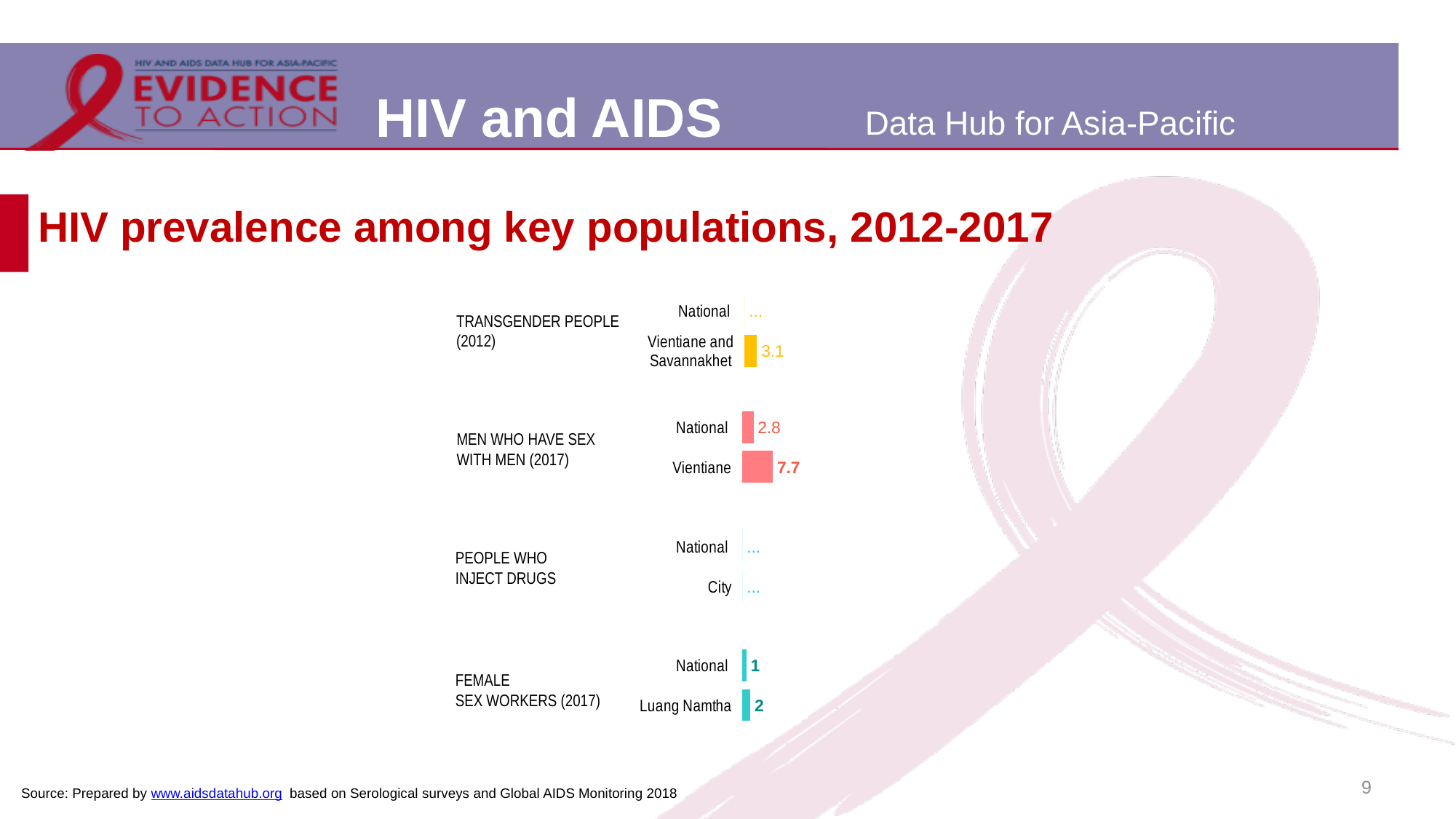
What is the difference between the Luang Namtha and national HIV prevalence among female sex workers (2017)? 1 Which is larger: the HIV prevalence among transgender people in Vientiane and Savannakhet (2012) or the national prevalence among men who have sex with men (2017)? Transgender people in Vientiane and Savannakhet (3.1) What is the HIV prevalence among female sex workers (2017) in Luang Namtha? 2 What is the HIV prevalence among transgender people (2012) in Vientiane and Savannakhet? 3.1 What is the national HIV prevalence among men who have sex with men (2017)? 2.8 What kind of chart is used on the slide? Bar chart What is the HIV prevalence among men who have sex with men (2017) in Vientiane? 7.7 What is the difference between the Vientiane and national HIV prevalence among men who have sex with men (2017)? 4.9 How many key population groups are shown on the chart? 4 Which bar shows the highest HIV prevalence value on the chart? Men who have sex with men (2017), Vientiane What is the title of the chart on the slide? HIV prevalence among key populations, 2012-2017 What is the national HIV prevalence among female sex workers (2017)? 1